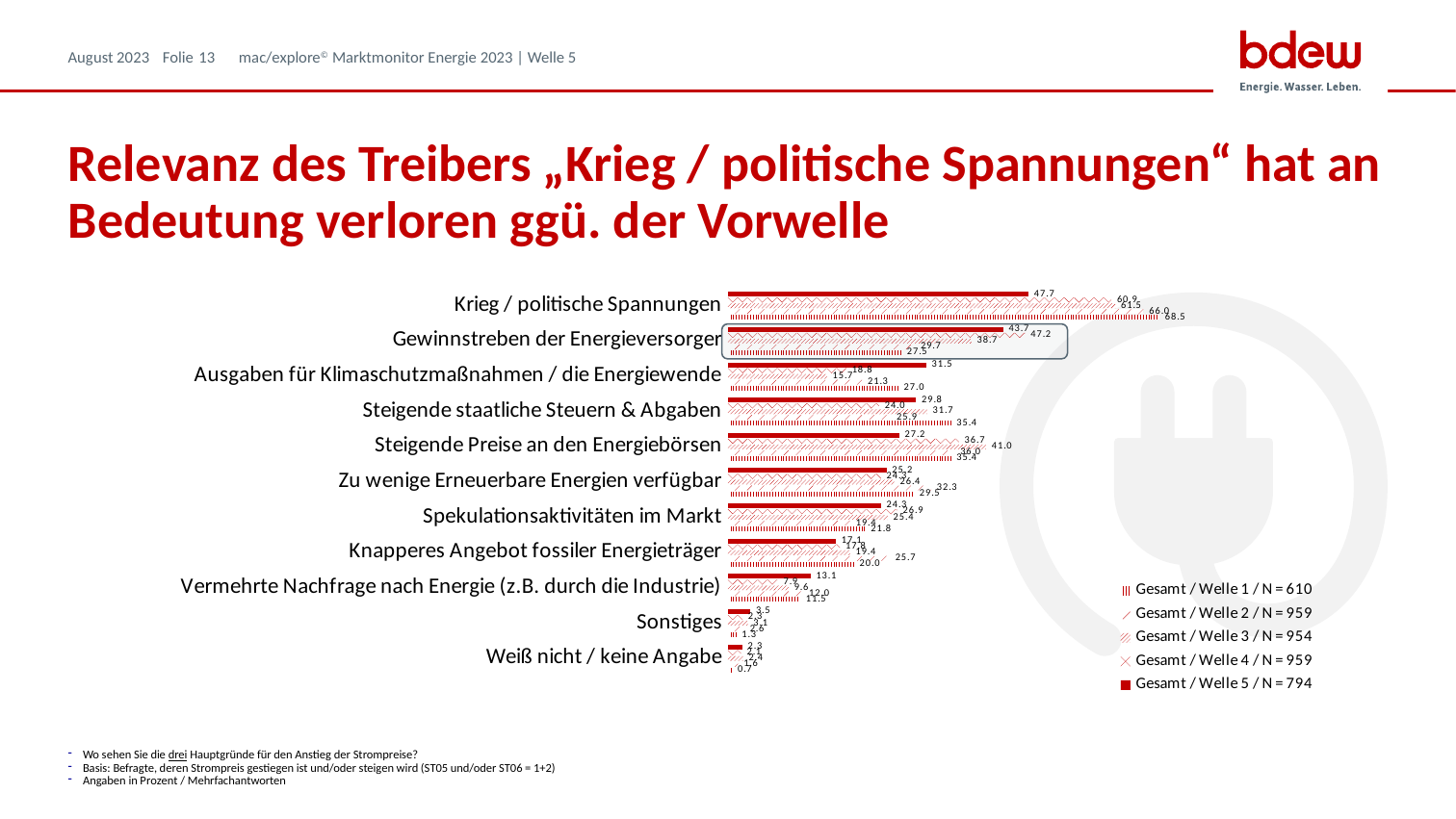
How many categories are plotted on the chart? 11 What is the value for "Vermehrte Nachfrage nach Energie (z.B. durch die Industrie)" in the series Gesamt / Welle 5? 13.1 What is the value for "Ausgaben für Klimaschutzmaßnahmen / die Energiewende" in the series Gesamt / Welle 5? 31.5 What kind of chart is shown on the slide? bar chart What is the difference between the Gesamt / Welle 5 values for "Krieg / politische Spannungen" and "Gewinnstreben der Energieversorger"? 4.0 What is the sample size (N) given in the legend for Gesamt / Welle 5? 794 What is the value for "Gewinnstreben der Energieversorger" in the series Gesamt / Welle 5? 43.7 Which series is shown with solid red bars according to the legend? Gesamt / Welle 5 / N = 794 How many series does the legend list? 5 For "Krieg / politische Spannungen", which is larger: the Gesamt / Welle 4 value or the Gesamt / Welle 5 value? Gesamt / Welle 4 What is the value for "Krieg / politische Spannungen" in the series Gesamt / Welle 5? 47.7 Which category has the highest value in the series Gesamt / Welle 5? Krieg / politische Spannungen